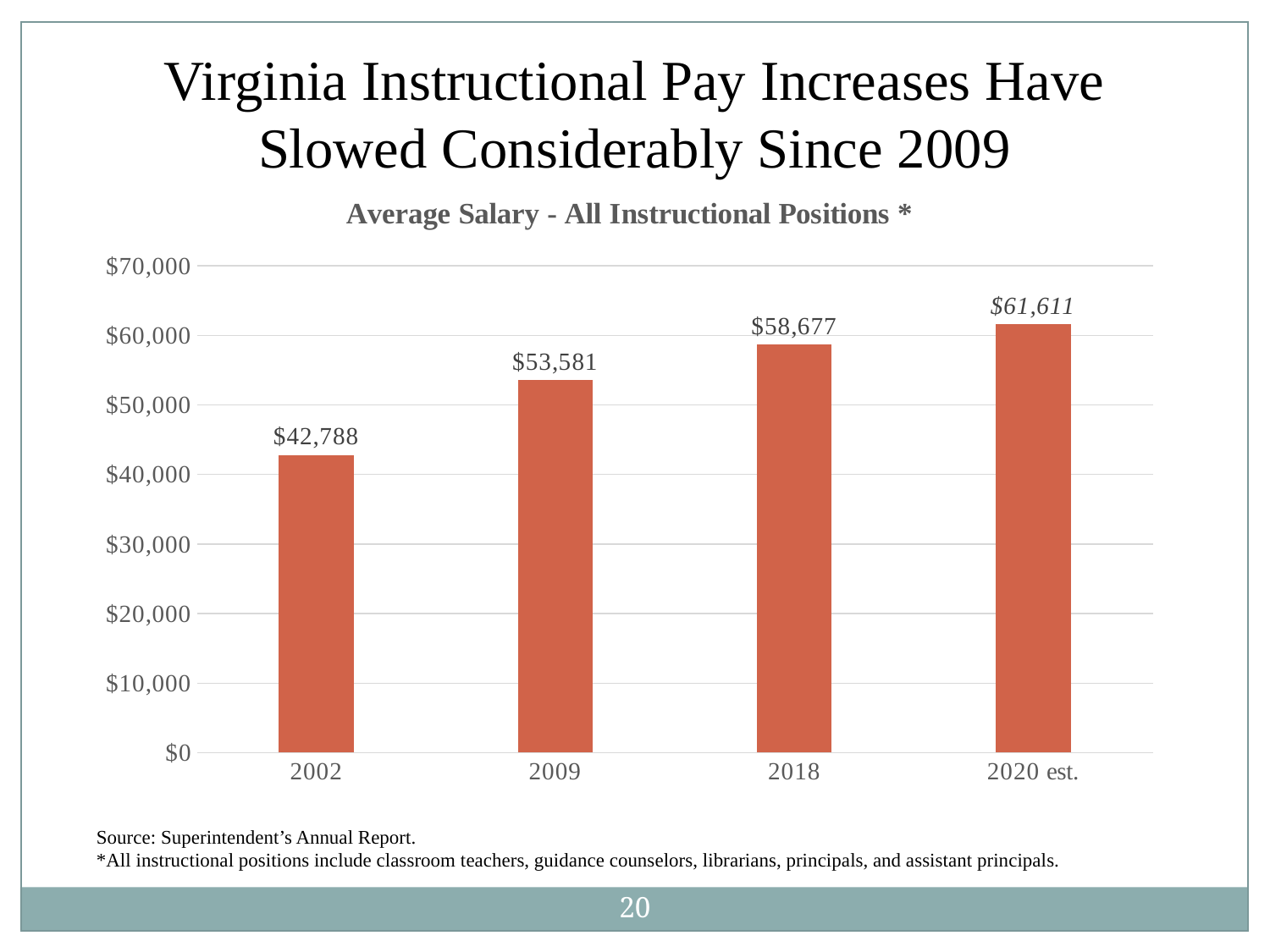
What is the difference between the average salary in 2009 and in 2002? $10,793 What is the average salary for all instructional positions in 2002? $42,788 What is the estimated average salary for all instructional positions in 2020? $61,611 What kind of chart is shown on the slide? Bar chart What is the difference between the average salary in 2018 and in 2009? $5,096 Which year has the lowest average salary? 2002 How many years are shown on the chart? 4 Do the average salary values rise or fall from 2002 to 2020 est.? Rise What is the average salary for all instructional positions in 2018? $58,677 Which year has the highest average salary? 2020 est. Which is larger, the average salary in 2018 or in 2009? 2018 What is the average salary for all instructional positions in 2009? $53,581